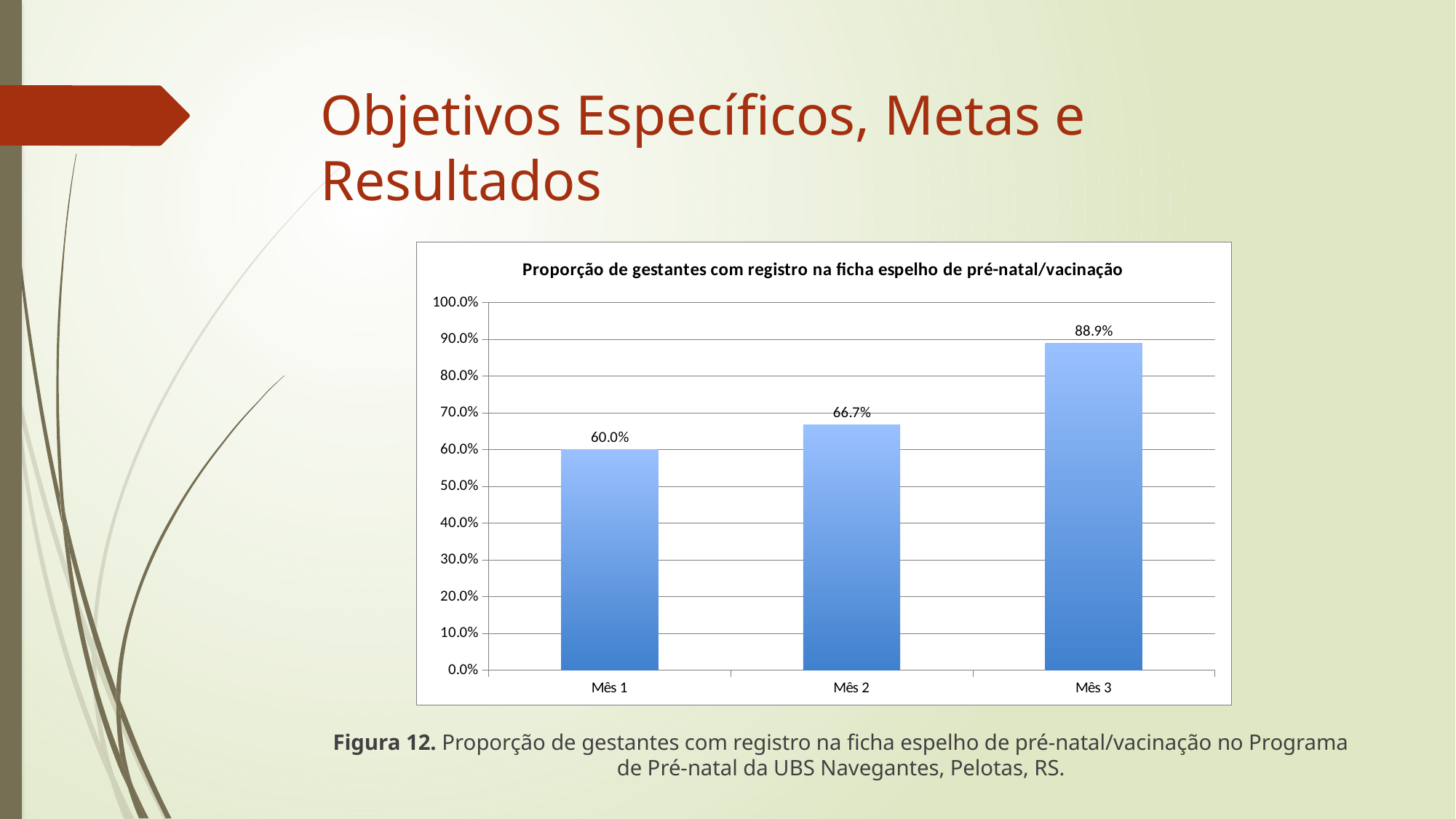
Do the values rise or fall from Mês 1 to Mês 3? rise What is the value for Mês 1? 60.0% What is the difference between the values for Mês 3 and Mês 1? 28.9% How many months are shown on the x axis? 3 Which month has the highest value? Mês 3 Which month has the lowest value? Mês 1 What is the value for Mês 3? 88.9% What is the value for Mês 2? 66.7% Is the value for Mês 3 greater or less than 80.0%? greater Which is larger, the value for Mês 2 or the value for Mês 3? Mês 3 What is the difference between the values for Mês 2 and Mês 1? 6.7% What kind of chart is shown on the slide? bar chart